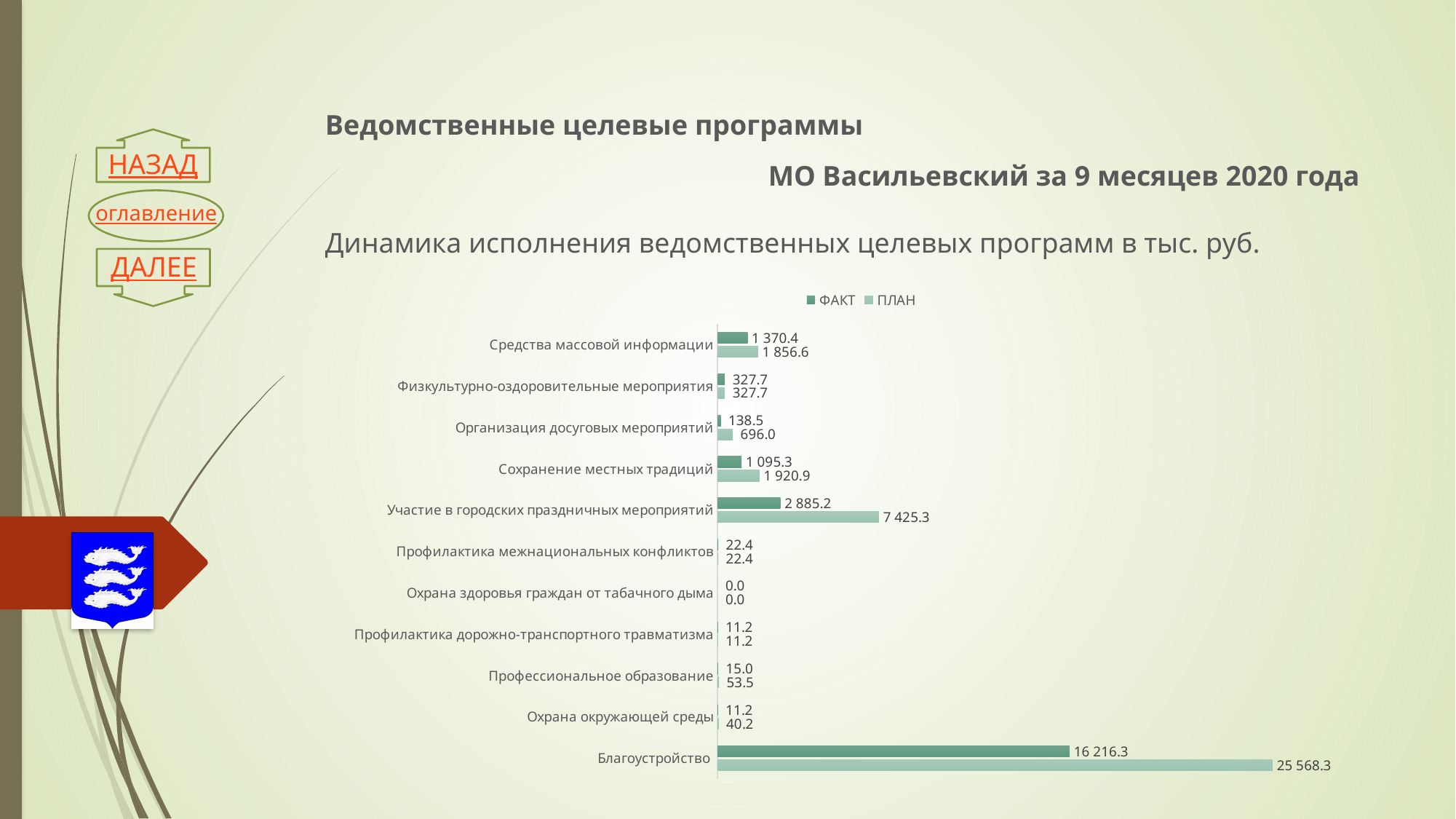
Which is larger for Сохранение местных традиций: the ФАКТ value or the ПЛАН value? ПЛАН How many categories are shown on the chart? 11 Which category has the highest ПЛАН value? Благоустройство What is the ПЛАН value for Участие в городских праздничных мероприятий? 7 425.3 Which category has the lowest ФАКТ value? Охрана здоровья граждан от табачного дыма What is the difference between the ПЛАН and ФАКТ values for Благоустройство? 9 352.0 What is the ПЛАН value for Профессиональное образование? 53.5 What are the two series named in the legend? ФАКТ and ПЛАН What is the ФАКТ value for Организация досуговых мероприятий? 138.5 What type of chart is shown on the slide? bar chart How many series does the legend list? 2 What is the ФАКТ value for Благоустройство? 16 216.3